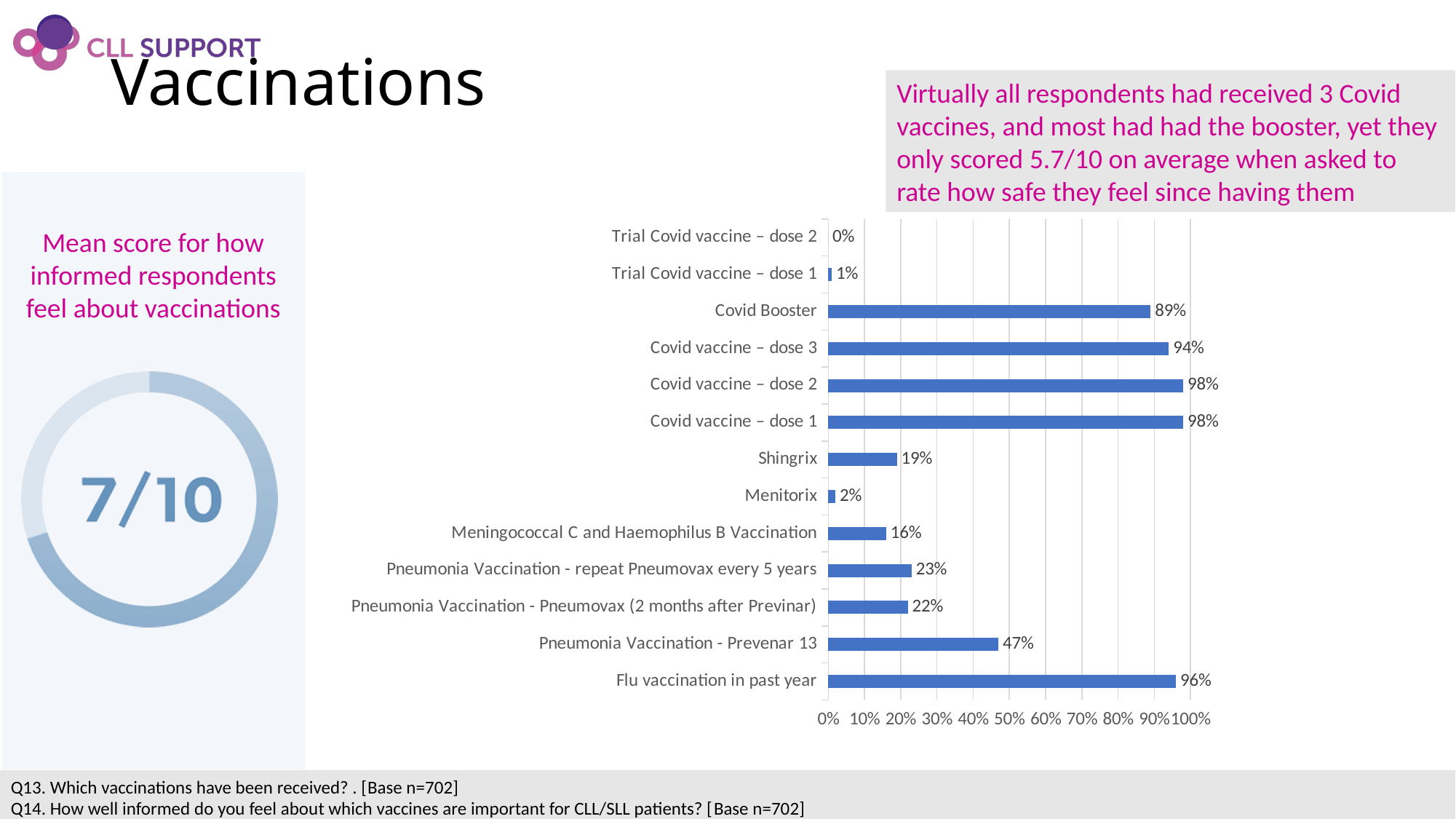
What percentage of respondents had a flu vaccination in the past year? 96% What is the mean score shown for how informed respondents feel about vaccinations? 7/10 What percentage of respondents received Shingrix? 19% Which vaccination has the lowest value in the chart? Trial Covid vaccine – dose 2 Is the value for Pneumonia Vaccination - repeat Pneumovax every 5 years greater or less than 30%? less What type of chart is used to show the vaccinations received? Bar chart What is the value for Pneumonia Vaccination - Prevenar 13? 47% What is the difference between the values for Covid vaccine – dose 3 and Covid Booster? 5% What is the difference between the values for Pneumonia Vaccination - Prevenar 13 and Shingrix? 28% How many vaccination categories are shown in the bar chart? 13 Which is larger: the value for Menitorix or the value for Meningococcal C and Haemophilus B Vaccination? Meningococcal C and Haemophilus B Vaccination What is the value shown for Covid Booster? 89%